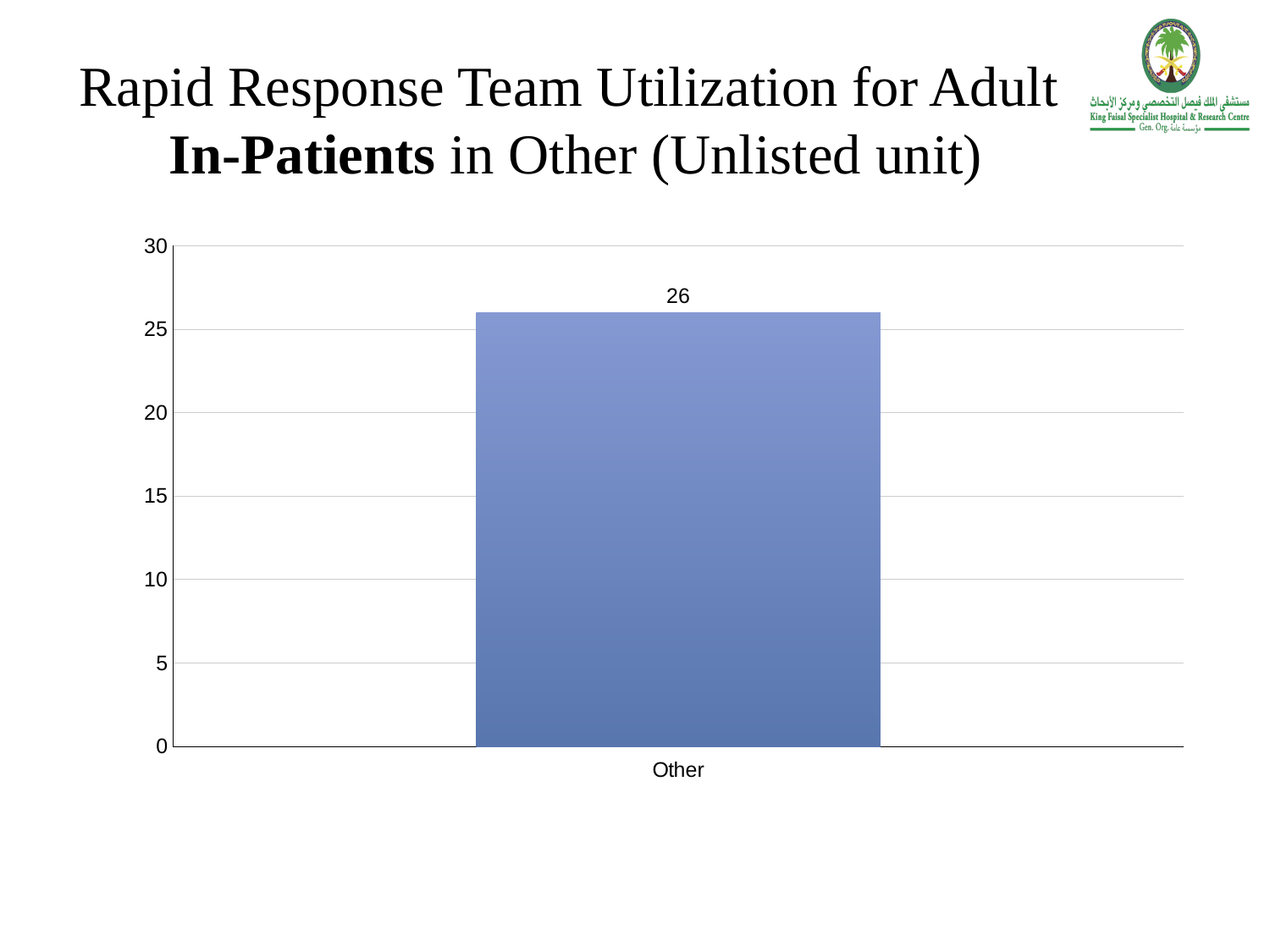
Is the value for Other greater or less than 30? less Is the value for Other greater or less than 25? greater What kind of chart is shown on the slide? bar chart What is the maximum value shown on the y axis? 30 How many categories are plotted on the chart? 1 What is the label of the category on the x axis? Other What is the value for Other? 26